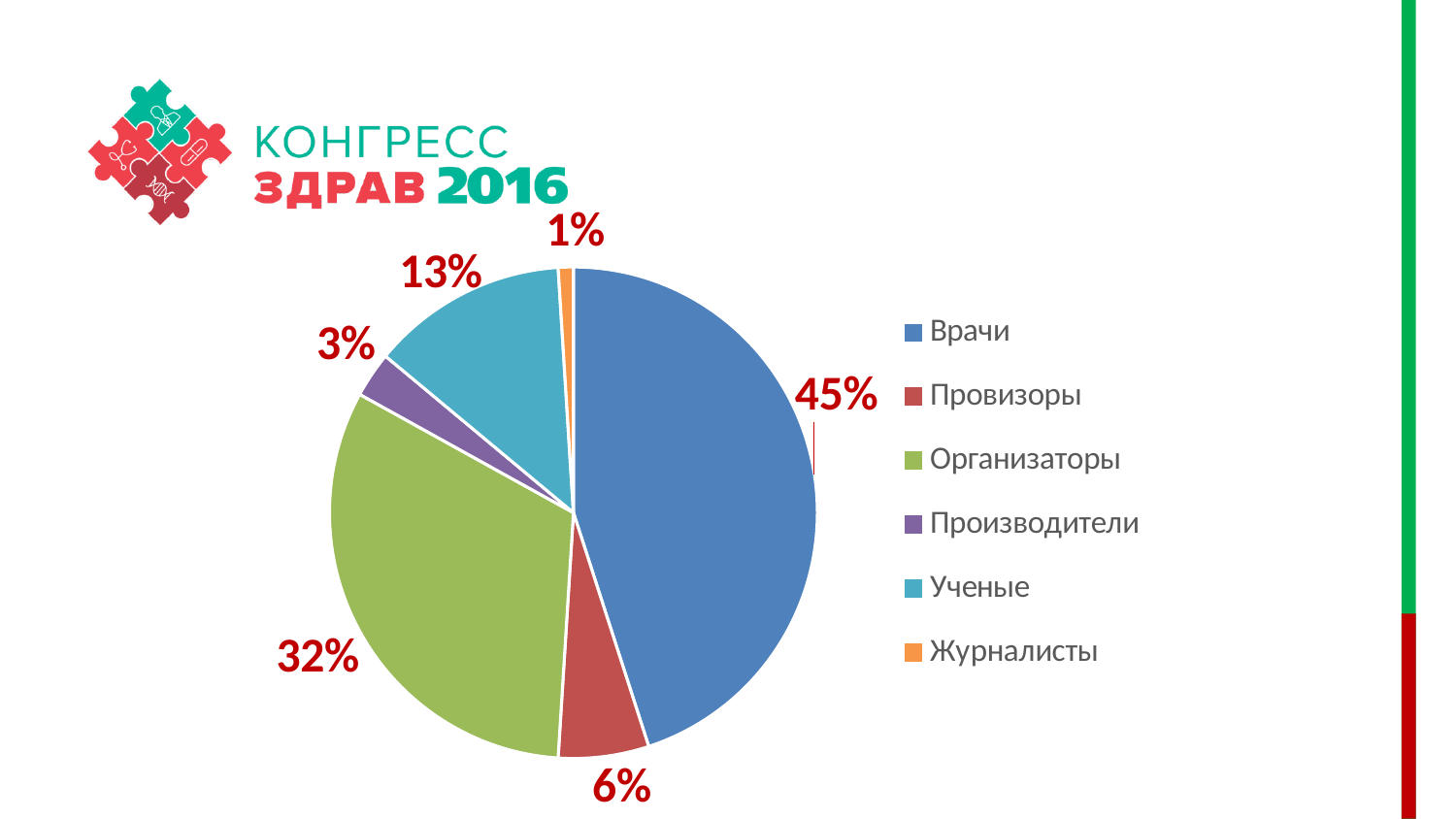
What share of the pie does Журналисты have? 1% What is the difference in percentage points between Врачи and Организаторы? 13 What share of the pie does Производители have? 3% What share of the pie does Врачи have? 45% What kind of chart is shown on the slide? pie chart Which is larger, the share for Ученые or the share for Провизоры? Ученые How many categories does the legend list? 6 Which category has the largest slice of the pie? Врачи Which category has the smallest slice of the pie? Журналисты